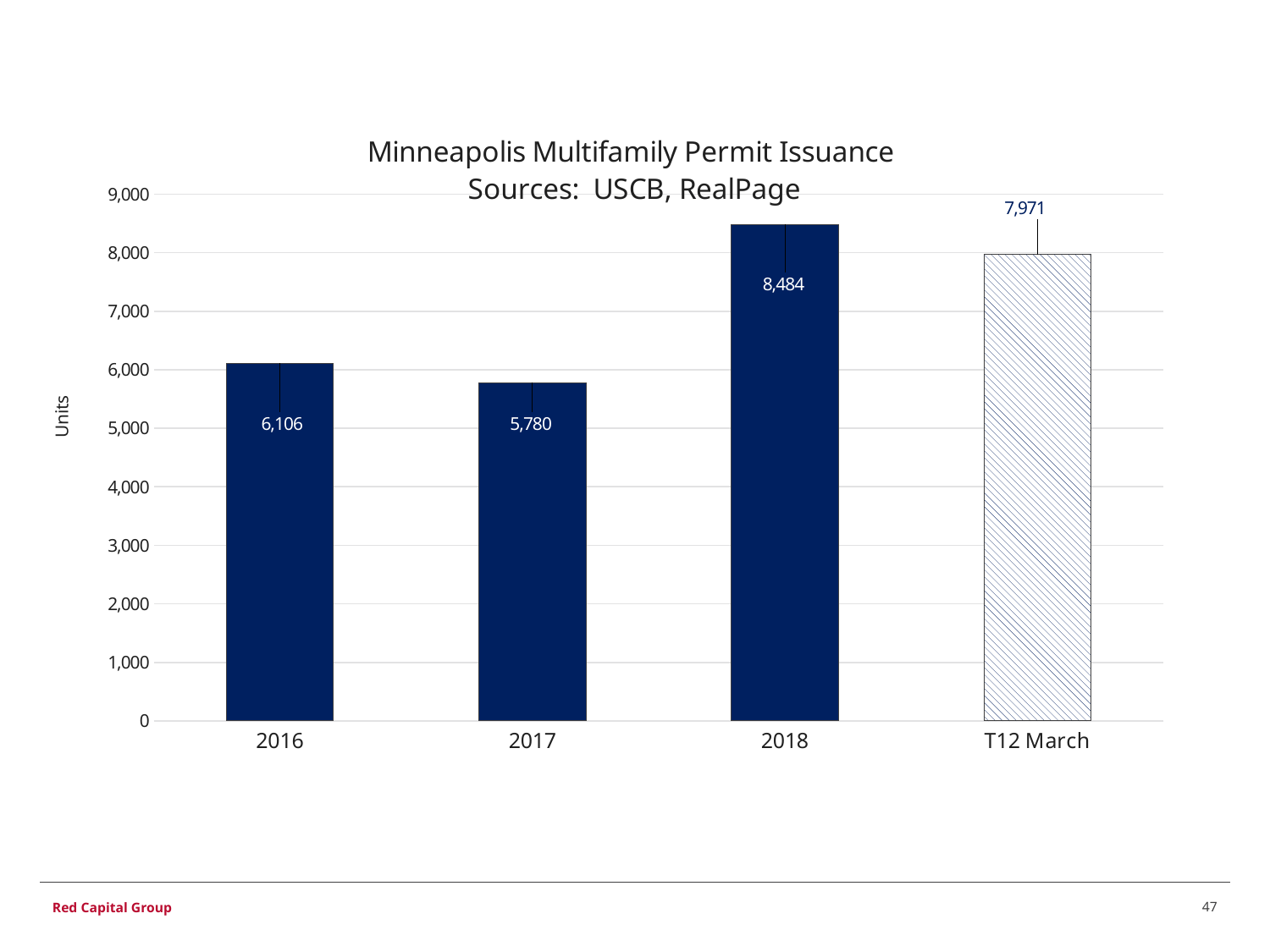
What is the value for 2018? 8,484 What is the value for T12 March? 7,971 What is the difference between the values for 2018 and 2017? 2,704 How many categories are shown on the x axis? 4 What is the difference between the values for 2016 and 2017? 326 What is the value for 2017? 5,780 What kind of chart is shown on the slide? bar chart Which category has the lowest value? 2017 Which is larger, the value for 2018 or the value for T12 March? 2018 Which category has the highest value? 2018 What is the value for 2016? 6,106 Is the value for 2018 greater or less than 8,000? greater